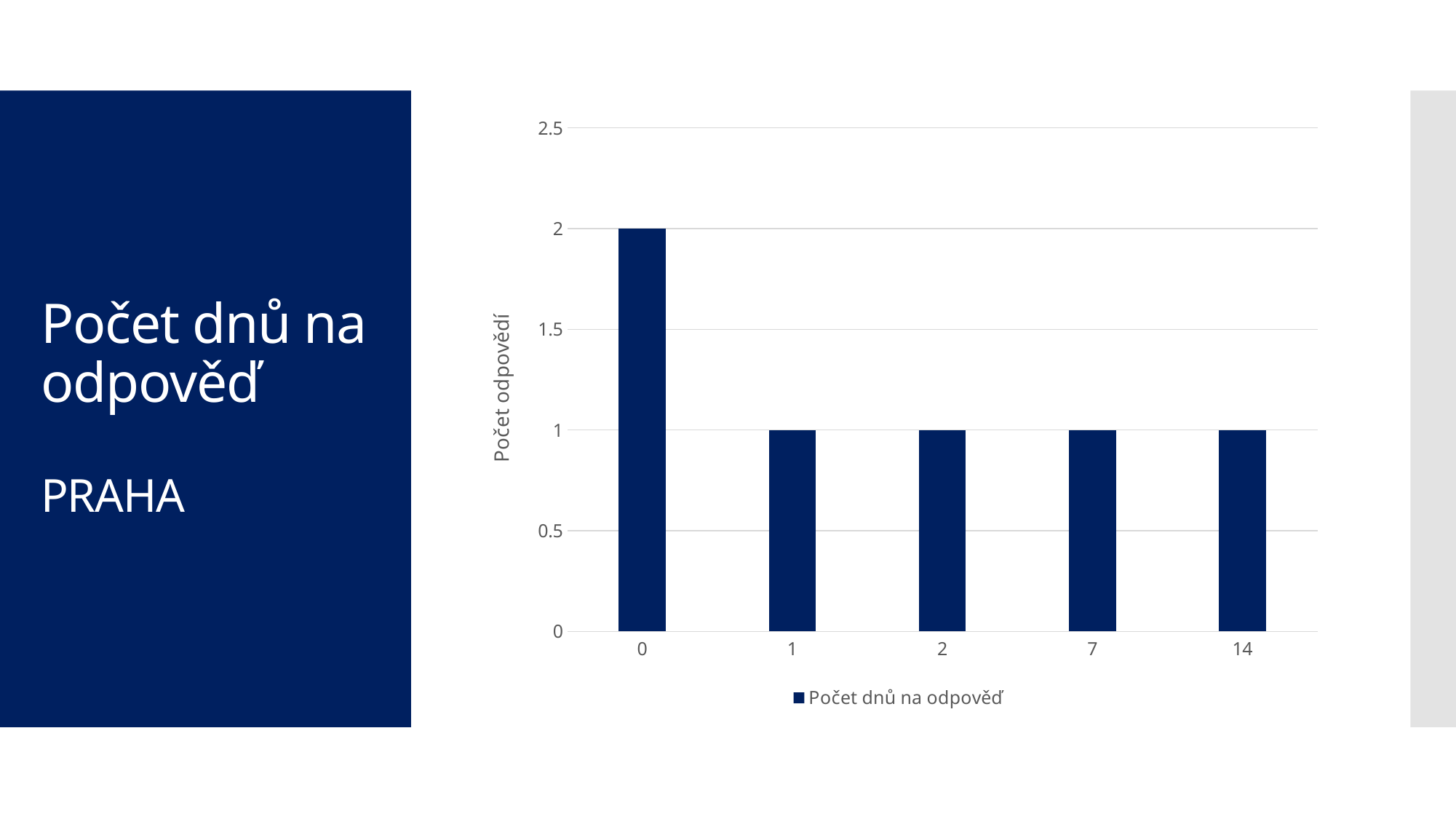
What is the difference between the values for category 0 and category 7? 1 What is the value for category 0 in the chart? 2 What is the value for category 14 in the chart? 1 Which has the larger value, category 0 or category 2? 0 How many series does the chart legend list? 1 What is the label of the y axis of the chart? Počet odpovědí What type of chart is shown on the slide? bar chart Which category has the highest value in the chart? 0 What is the value for category 1 in the chart? 1 What series name is shown in the chart legend? Počet dnů na odpověď Is the value for category 0 greater or less than 1.5? greater How many categories are shown on the x axis of the chart? 5